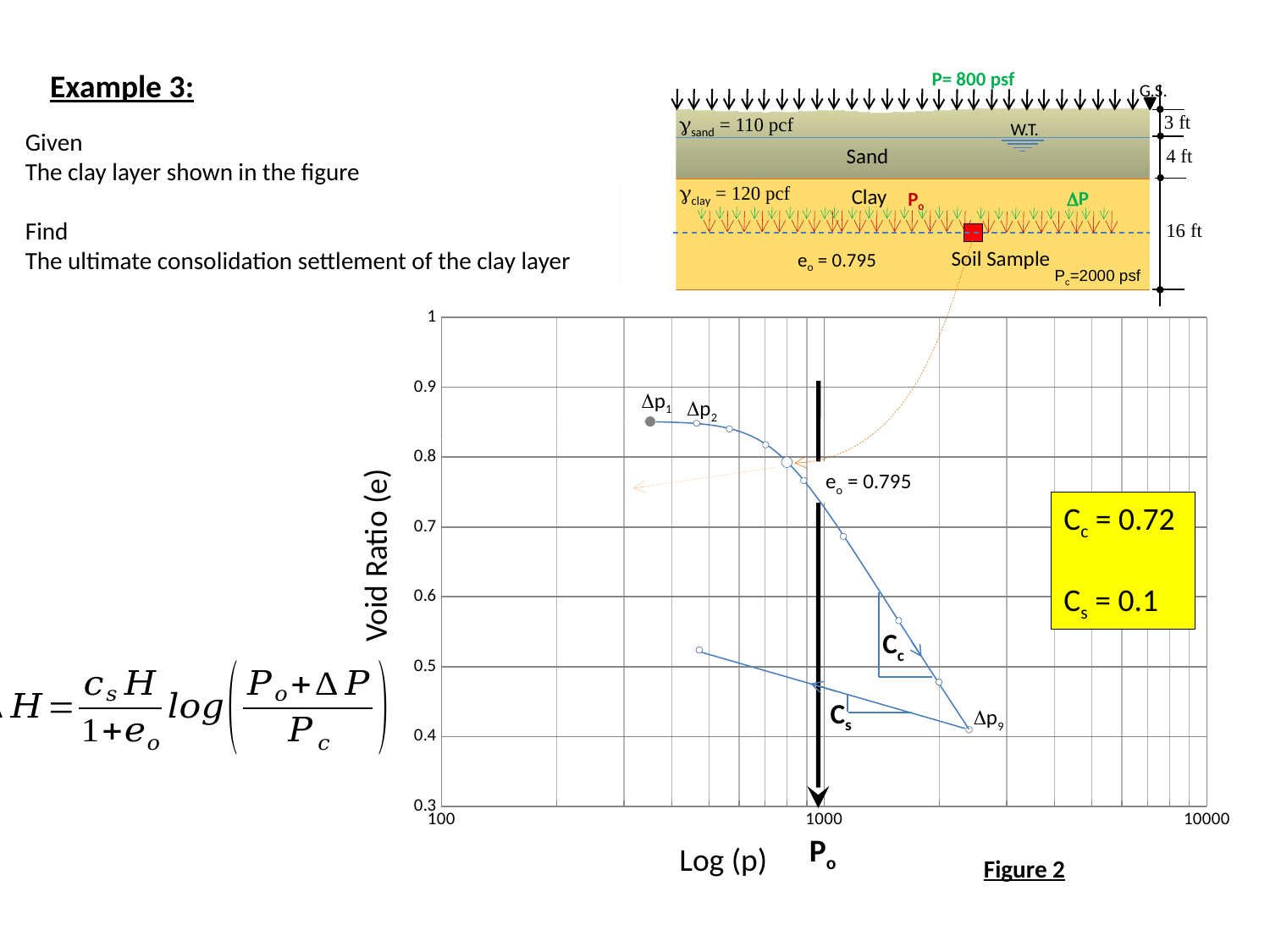
What is the lowest value shown on the horizontal axis of the chart? 100 What is the highest value shown on the vertical axis of the chart? 1 What is the value of e_o marked on the void ratio chart? 0.795 Is the void ratio at point Δp1 greater or less than 0.8? greater What is the label of the vertical axis of the chart? Void Ratio (e) Which labeled point has the higher void ratio, Δp1 or Δp9? Δp1 What kind of chart is shown on the slide? line chart Does the void ratio rise or fall as p increases along the x axis? fall What value of C_s is given in the box beside the chart? 0.1 Is the void ratio at point Δp9 greater or less than 0.5? less What value of C_c is given in the box beside the chart? 0.72 What figure number is given below the chart? Figure 2